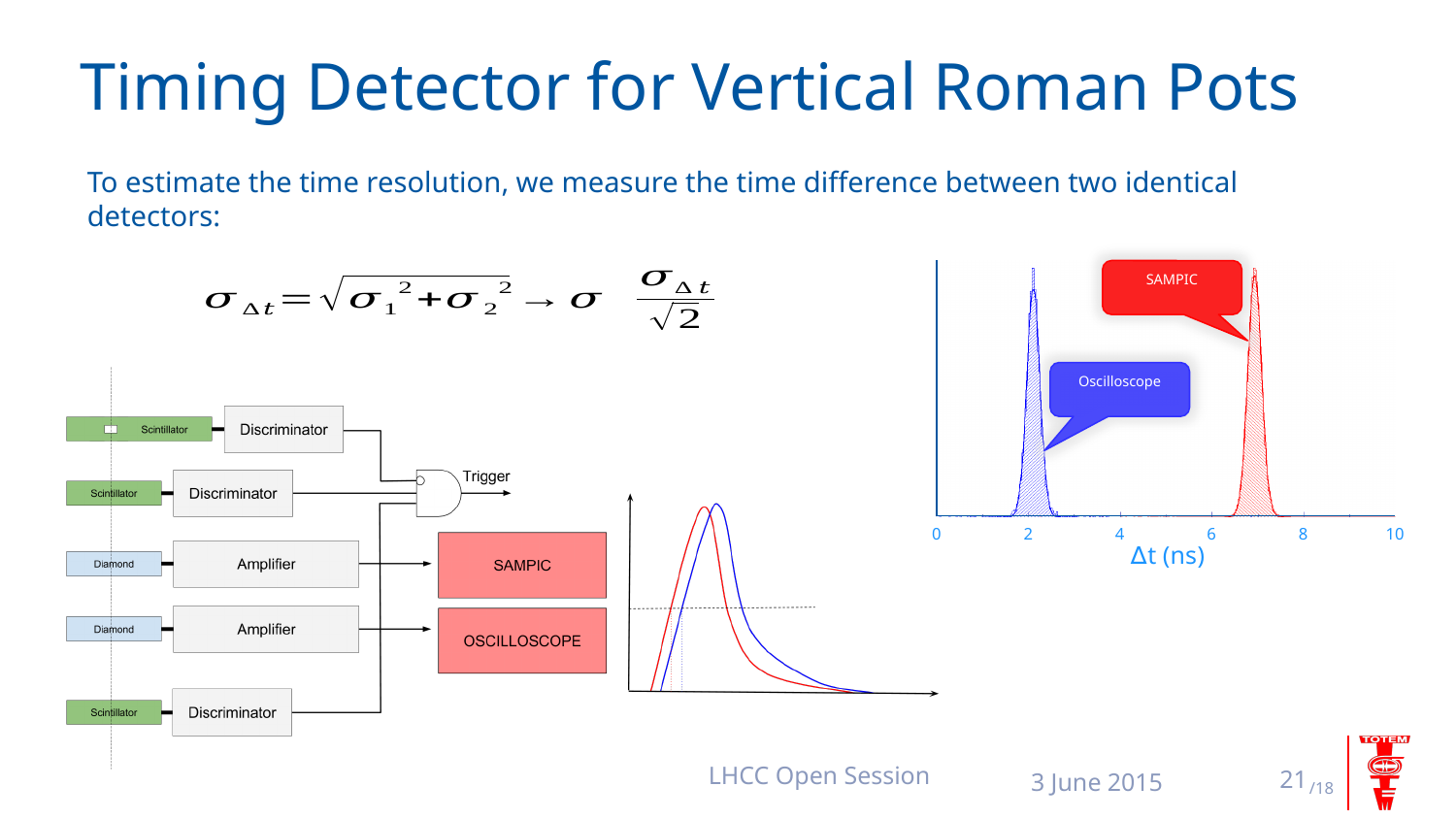
In the histogram on the right, is the peak of the SAMPIC distribution at a Δt greater or less than 8 ns? less How many labelled tick values are shown on the x-axis of the histogram on the right? 6 In the histogram on the right, is the peak of the SAMPIC distribution at a Δt greater or less than 6 ns? greater What is the largest tick value shown on the x-axis of the histogram on the right? 10 In the histogram on the right, which series is drawn in blue? Oscilloscope In the histogram on the right, which distribution peaks at a larger Δt, SAMPIC or Oscilloscope? SAMPIC What is the x-axis label of the histogram on the right of the slide? Δt (ns) What kind of chart is shown on the right of the slide? Histogram How many series are labelled in the histogram on the right of the slide? 2 In the histogram on the right, which colour is used for the SAMPIC distribution? Red In the histogram on the right, is the peak of the Oscilloscope distribution at a Δt greater or less than 4 ns? less